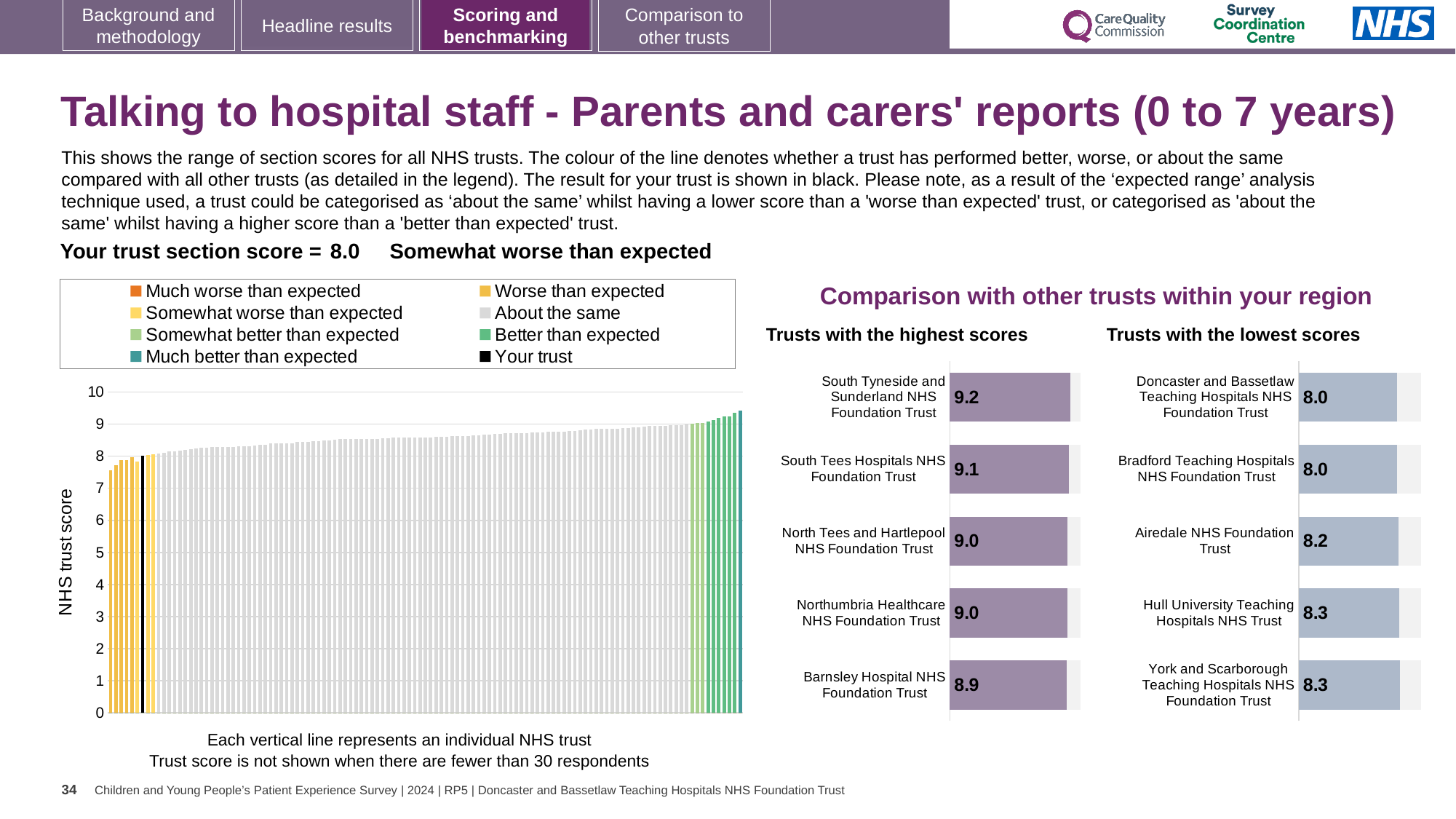
In the 'Trusts with the highest scores' chart, what is the score for South Tyneside and Sunderland NHS Foundation Trust? 9.2 How many entries does the legend of the large chart on the left list? 8 What kind of chart is the large chart on the left showing NHS trust scores? Bar chart In the 'Trusts with the highest scores' chart, which trust has the highest score? South Tyneside and Sunderland NHS Foundation Trust In the large chart on the left, is the value of the tallest bar greater or less than 9? greater In the 'Trusts with the highest scores' chart, what is the difference between the scores of South Tyneside and Sunderland NHS Foundation Trust and Barnsley Hospital NHS Foundation Trust? 0.3 In the 'Trusts with the lowest scores' chart, which has the larger score: Hull University Teaching Hospitals NHS Trust or Airedale NHS Foundation Trust? Hull University Teaching Hospitals NHS Trust How many trusts are shown in the 'Trusts with the highest scores' chart? 5 How many trusts are shown in the 'Trusts with the lowest scores' chart? 5 In the 'Trusts with the highest scores' chart, which trust has the lowest score? Barnsley Hospital NHS Foundation Trust In the 'Trusts with the lowest scores' chart, what is the score for Airedale NHS Foundation Trust? 8.2 In the 'Trusts with the lowest scores' chart, what is the difference between the scores of York and Scarborough Teaching Hospitals NHS Foundation Trust and Doncaster and Bassetlaw Teaching Hospitals NHS Foundation Trust? 0.3